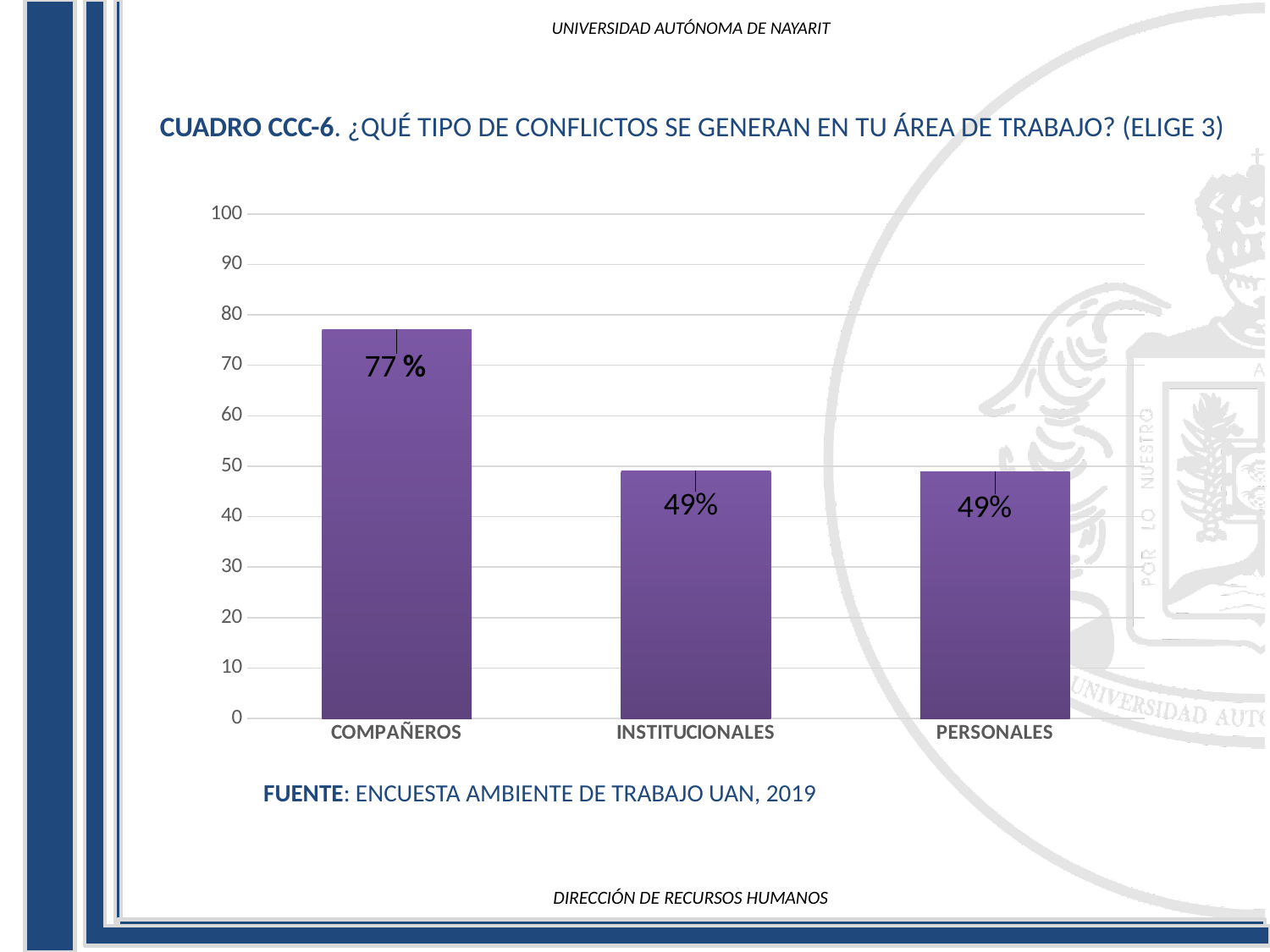
Do the values for INSTITUCIONALES and PERSONALES differ? No, both are 49% What kind of chart is shown on the slide? Bar chart What is the difference between the values for COMPAÑEROS and INSTITUCIONALES? 28 percentage points Which category has the highest value? COMPAÑEROS Is the value for COMPAÑEROS greater or less than 70? greater What source is cited below the chart? ENCUESTA AMBIENTE DE TRABAJO UAN, 2019 What is the value for INSTITUCIONALES? 49% Is the value for INSTITUCIONALES greater or less than 50? less What is the value for COMPAÑEROS? 77 % How many categories are shown on the x axis? 3 What is the value for PERSONALES? 49% Which is larger, the value for COMPAÑEROS or the value for PERSONALES? COMPAÑEROS